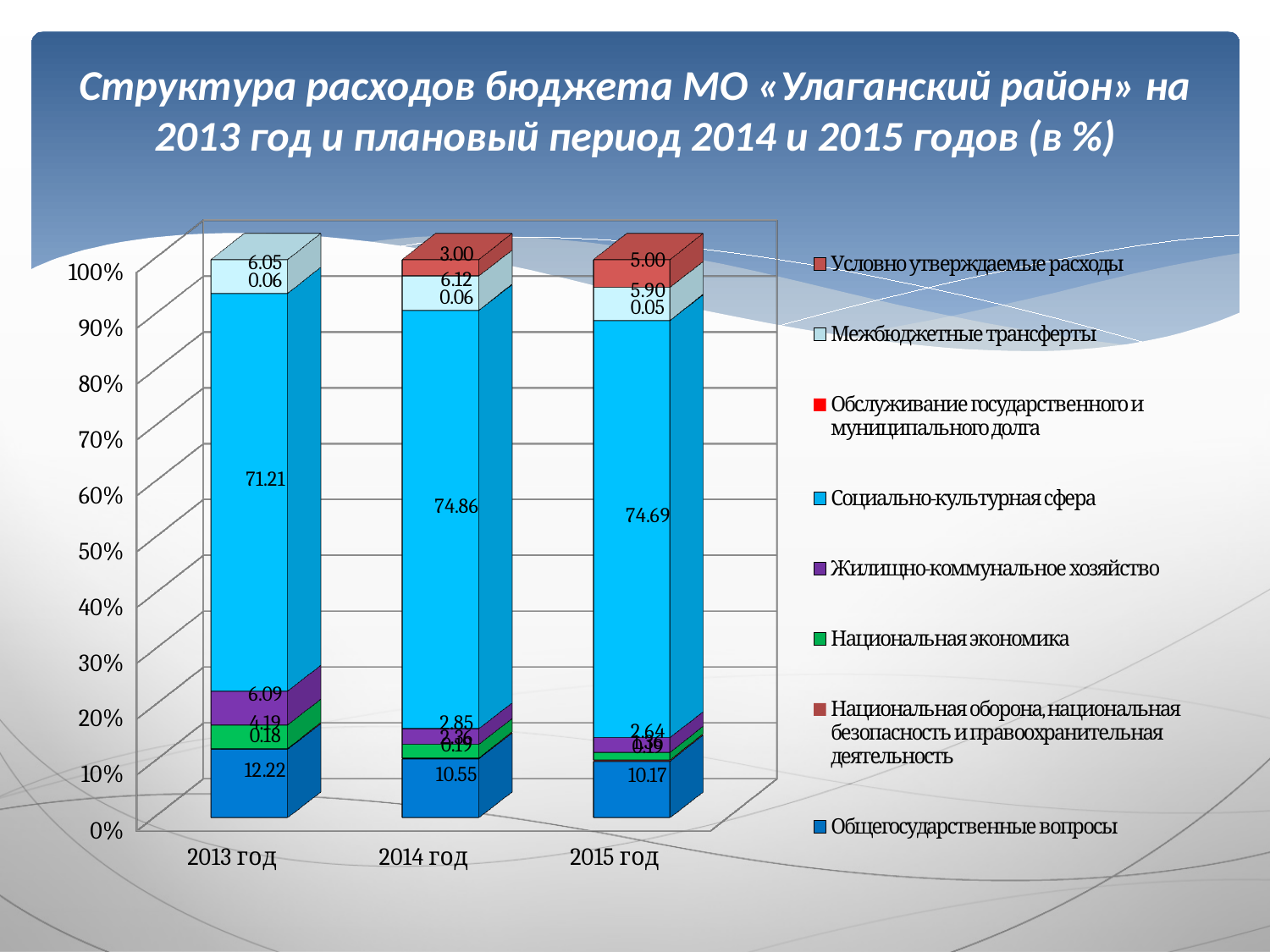
What is the value for Социально-культурная сфера in 2014 год? 74.86 In which year is the Социально-культурная сфера share the highest? 2014 год Which is larger, the Межбюджетные трансферты value for 2014 год or for 2015 год? 2014 год Does the Общегосударственные вопросы share rise or fall from 2013 год to 2015 год? Fall What is the value for Условно утверждаемые расходы in 2015 год? 5.00 What is the value for Межбюджетные трансферты in 2013 год? 6.05 What kind of chart is shown on the slide? Stacked bar chart How many years are shown on the x axis? 3 What is the difference between the Общегосударственные вопросы values for 2013 год and 2015 год? 2.05 In which year is the Общегосударственные вопросы share the lowest? 2015 год How many series does the legend list? 8 What is the value for Общегосударственные вопросы in 2013 год? 12.22